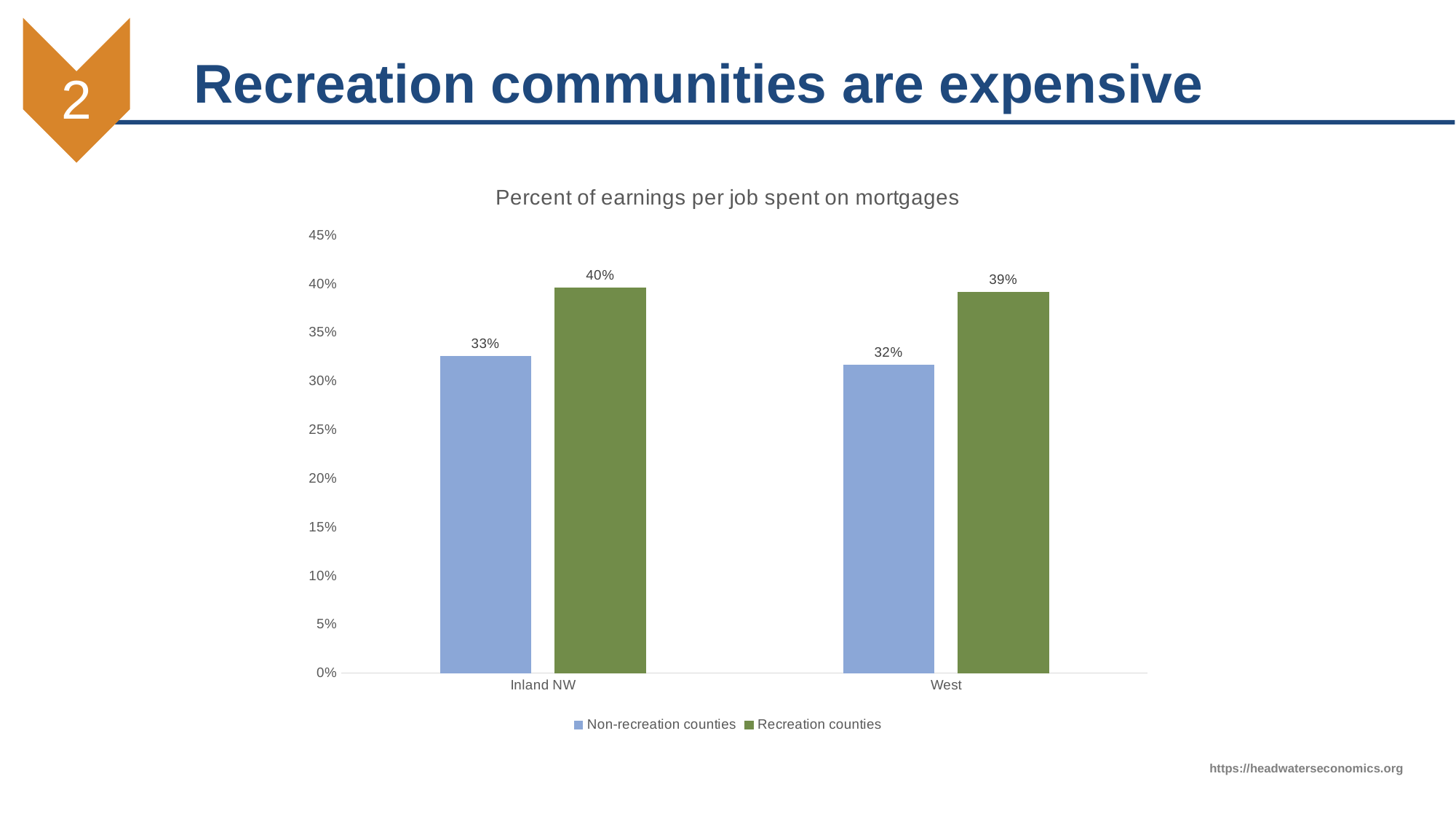
Which region has the highest value for Recreation counties? Inland NW What is the value for Recreation counties in Inland NW? 40% How many series does the legend list? 2 How many regions are shown on the x axis? 2 What is the difference between Recreation counties and Non-recreation counties in West? 7% What is the value for Recreation counties in West? 39% What is the value for Non-recreation counties in Inland NW? 33% Which region has the lowest value for Non-recreation counties? West In West, which is larger: Recreation counties or Non-recreation counties? Recreation counties What is the value for Non-recreation counties in West? 32% What kind of chart is shown on the slide? Bar chart What is the difference between Recreation counties and Non-recreation counties in Inland NW? 7%